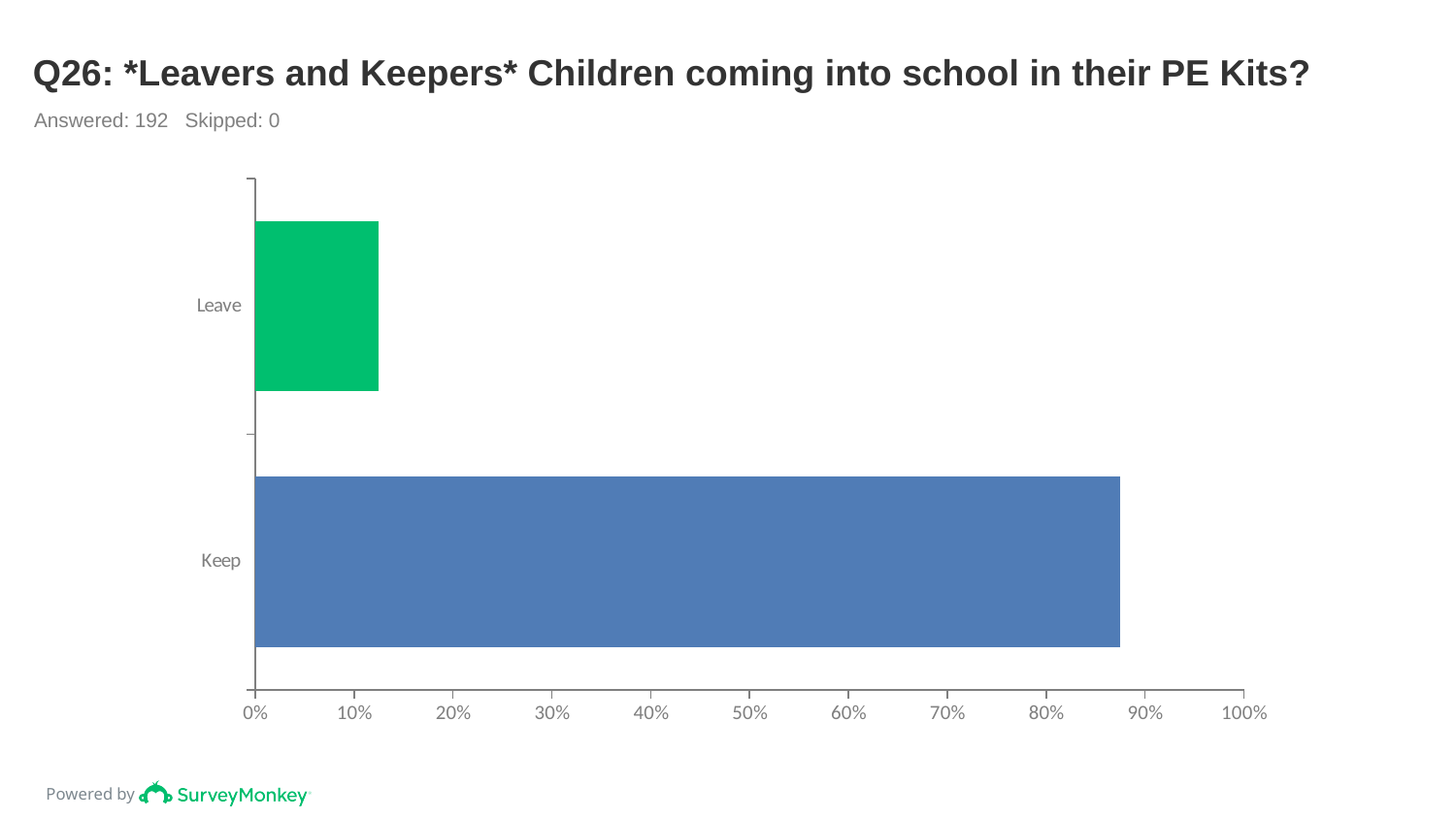
Which category has the lowest value? Leave Is the value for Leave greater or less than 20%? less How many categories are plotted in the chart? 2 Which is larger, the value for Keep or the value for Leave? Keep What kind of chart is shown on the slide? bar chart Is the value for Keep greater or less than 90%? less Which category has the highest value? Keep Is the value for Leave greater or less than 10%? greater What is the title of the chart? Q26: *Leavers and Keepers* Children coming into school in their PE Kits? How many respondents answered the question according to the slide? 192